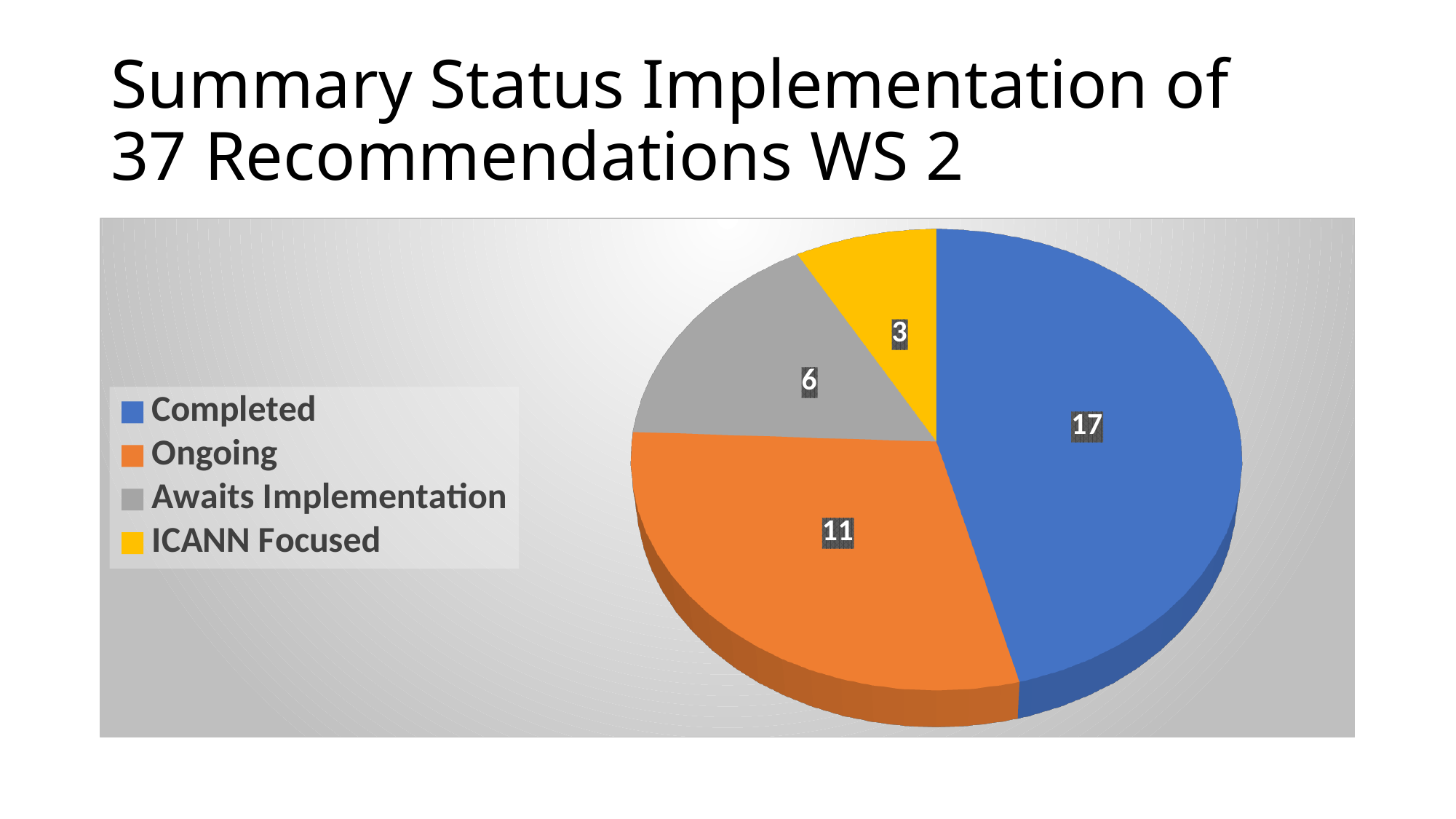
What colour is the Ongoing slice? Orange How many recommendations are Completed? 17 What type of chart is shown on the slide? Pie chart How many recommendations are Ongoing? 11 What is the total of all the slices in the pie chart? 37 Which category has the largest slice of the pie? Completed How many categories does the pie chart have? 4 What is the difference between the number of Completed and Ongoing recommendations? 6 Which category has the smallest slice of the pie? ICANN Focused How many recommendations are in the Awaits Implementation category? 6 How many recommendations are ICANN Focused? 3 Which is larger, the Awaits Implementation slice or the ICANN Focused slice? Awaits Implementation